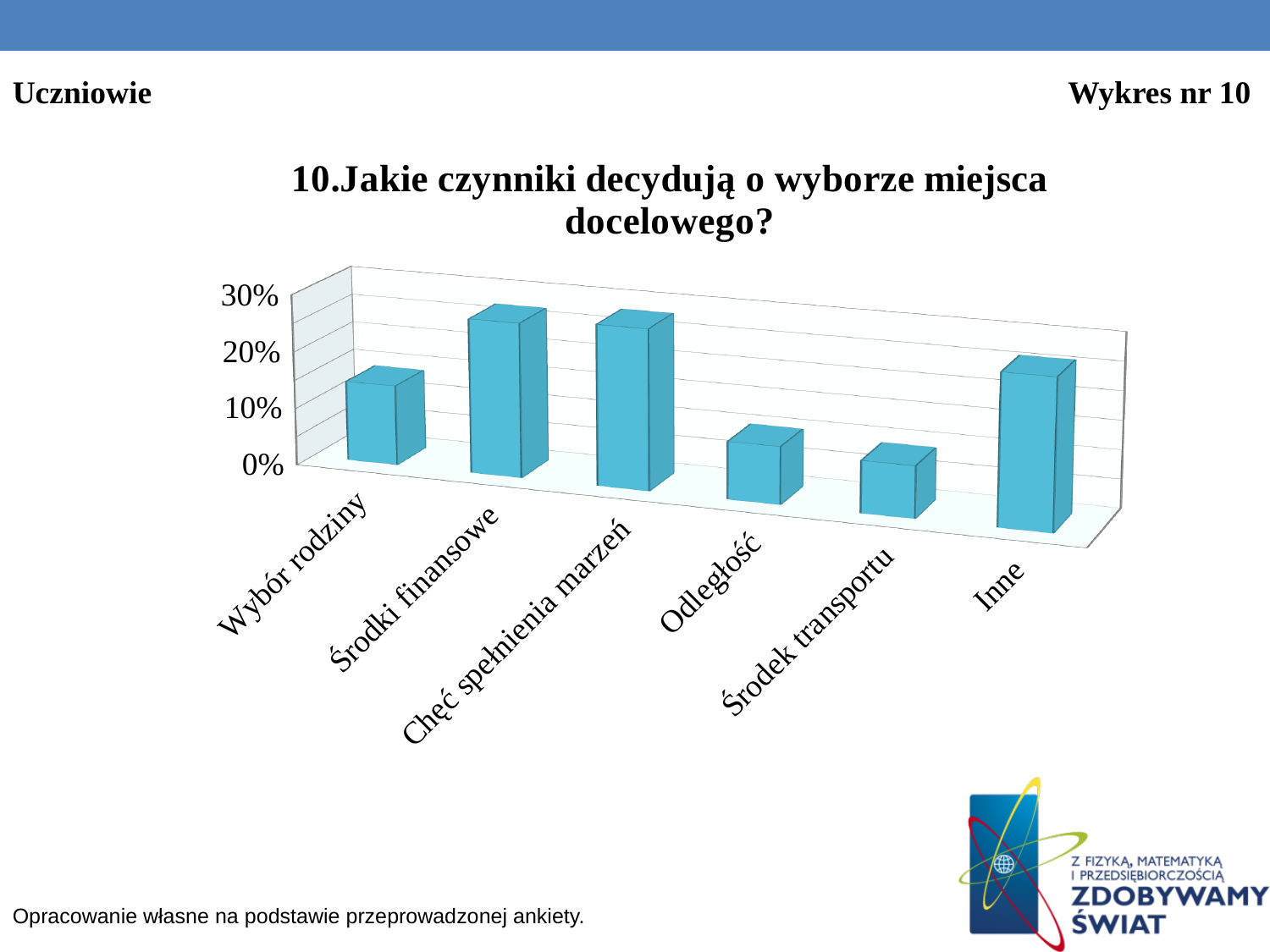
What kind of chart is shown on the slide? bar chart Which is larger, the value for Inne or the value for Wybór rodziny? Inne How many categories are shown on the x axis of the chart? 6 Is the value for Wybór rodziny greater or less than 10%? greater Which is larger, the value for Chęć spełnienia marzeń or the value for Środek transportu? Chęć spełnienia marzeń Is the value for Chęć spełnienia marzeń greater or less than 20%? greater Is the value for Środki finansowe greater or less than 20%? greater Which is larger, the value for Środki finansowe or the value for Odległość? Środki finansowe What is the title of the chart? 10.Jakie czynniki decydują o wyborze miejsca docelowego?